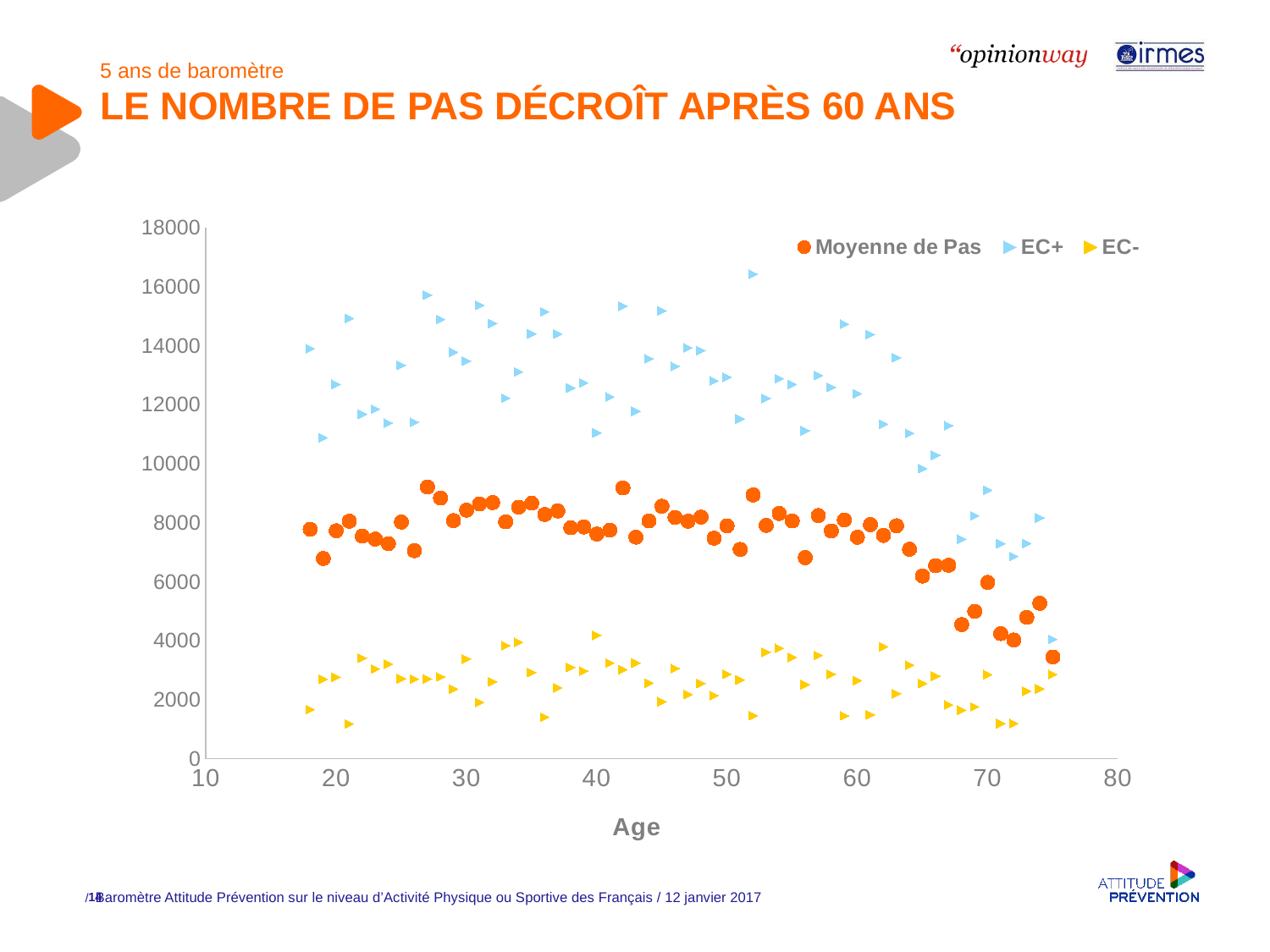
What is the title of the horizontal axis? Age How many series does the legend list? 3 Is the EC+ value at age 52 greater or less than 14000? greater Is the EC- value at age 21 greater or less than 2000? less What kind of chart is shown on the slide? scatter chart Which is larger, the Moyenne de Pas value at age 27 or at age 75? age 27 At age 40, which series has the larger value, EC+ or EC-? EC+ Does the Moyenne de Pas series rise or fall between age 60 and age 75? fall Is the Moyenne de Pas value at age 75 greater or less than 6000? less What are the three series named in the legend? Moyenne de Pas, EC+, EC-